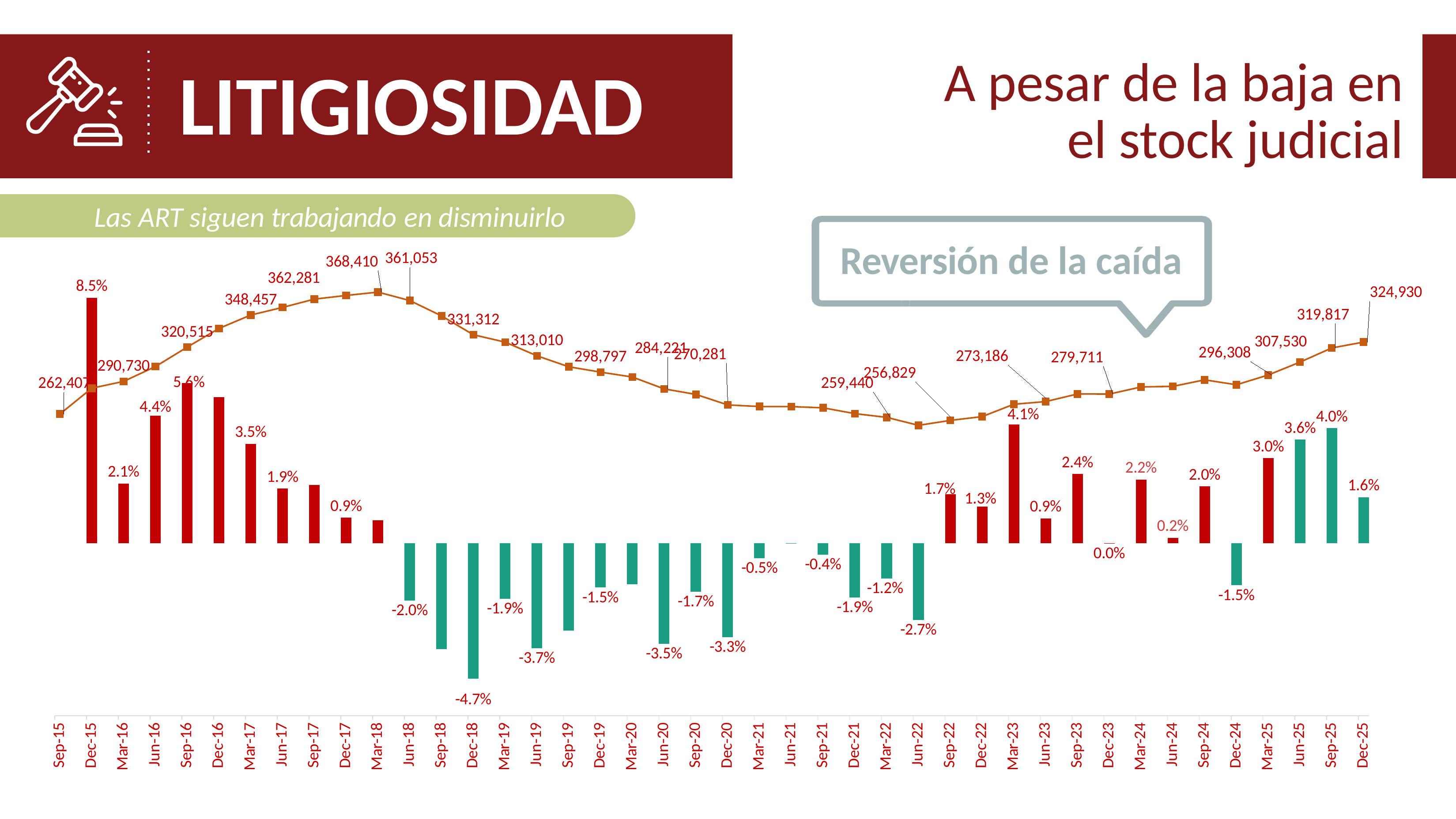
How many quarters are shown along the x axis of the chart? 42 What is the percentage change shown for Dec-18? -4.7% What is the judicial stock value shown for Sep-15? 262,407 By how much did the judicial stock grow from Sep-15 (262,407) to Dec-25 (324,930)? 62,523 Which is larger, the percentage change for Mar-23 or for Sep-23? Mar-23 (4.1%) Which quarter has the lowest percentage change bar? Dec-18 (-4.7%) Does the judicial stock line rise or fall between Mar-18 and Jun-22? It falls What kind of chart is shown on the slide? A combined bar and line chart In which quarter does the judicial stock line reach its highest value, and what is that value? Mar-18, 368,410 What is the judicial stock value shown for Dec-25? 324,930 Which quarter has the highest percentage change bar? Dec-15 (8.5%) What is the percentage change shown for Mar-23? 4.1%